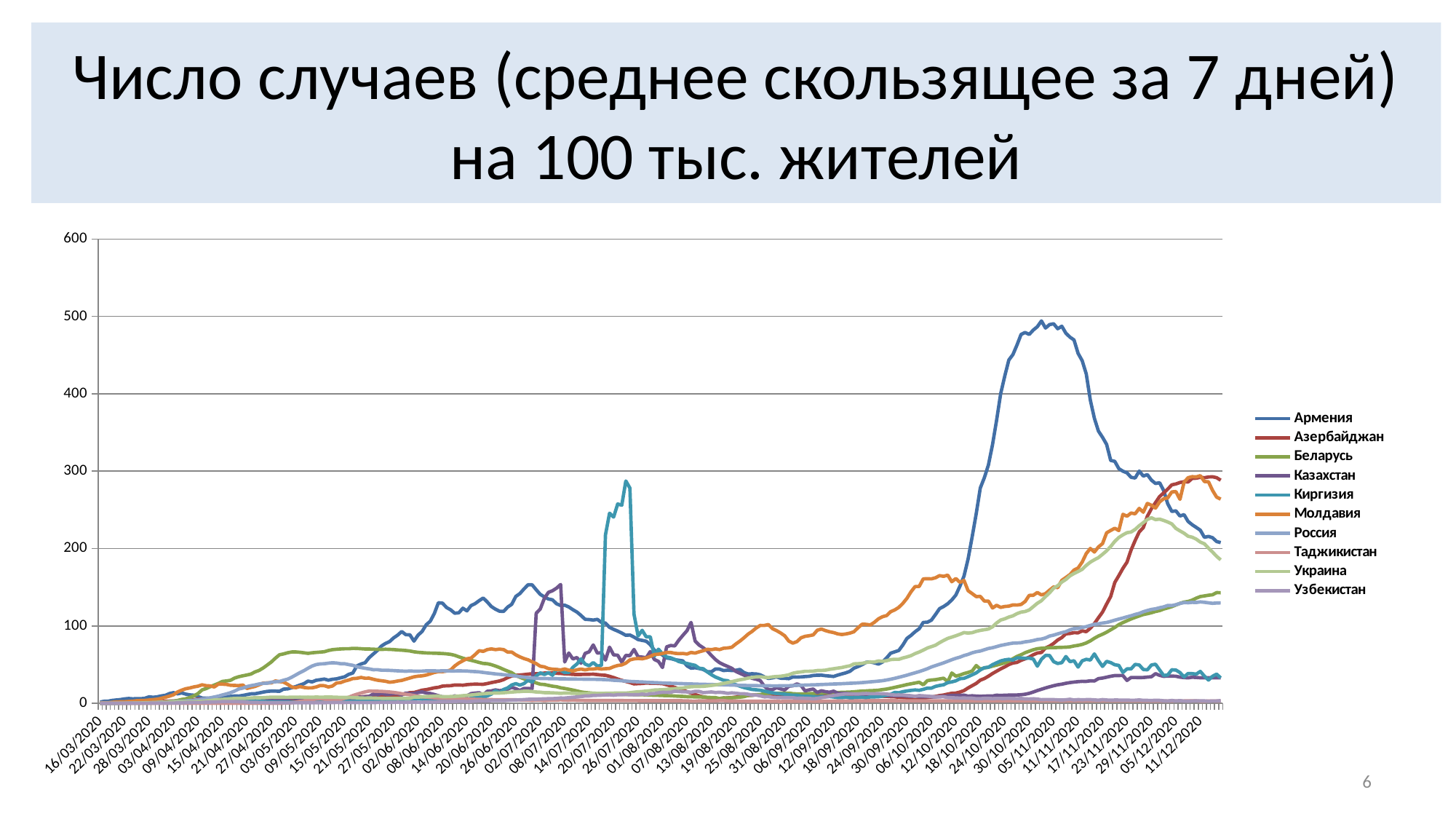
Does the value for Азербайджан rise or fall between 18/10/2020 and 05/12/2020? rise Does the value for Армения rise or fall between 05/11/2020 and 11/12/2020? fall Is the highest value for Таджикистан greater or less than 100? less What kind of chart is shown on the slide? line chart Which series reaches the highest peak value on the chart? Армения Is the peak value for Киргизия greater or less than 200? greater At 11/12/2020, which is higher, Азербайджан or Беларусь? Азербайджан How many series does the legend list? 10 Is the peak value for Армения greater or less than 400? greater Which series is drawn in orange? Молдавия What is the title of the chart? Число случаев (среднее скользящее за 7 дней) на 100 тыс. жителей